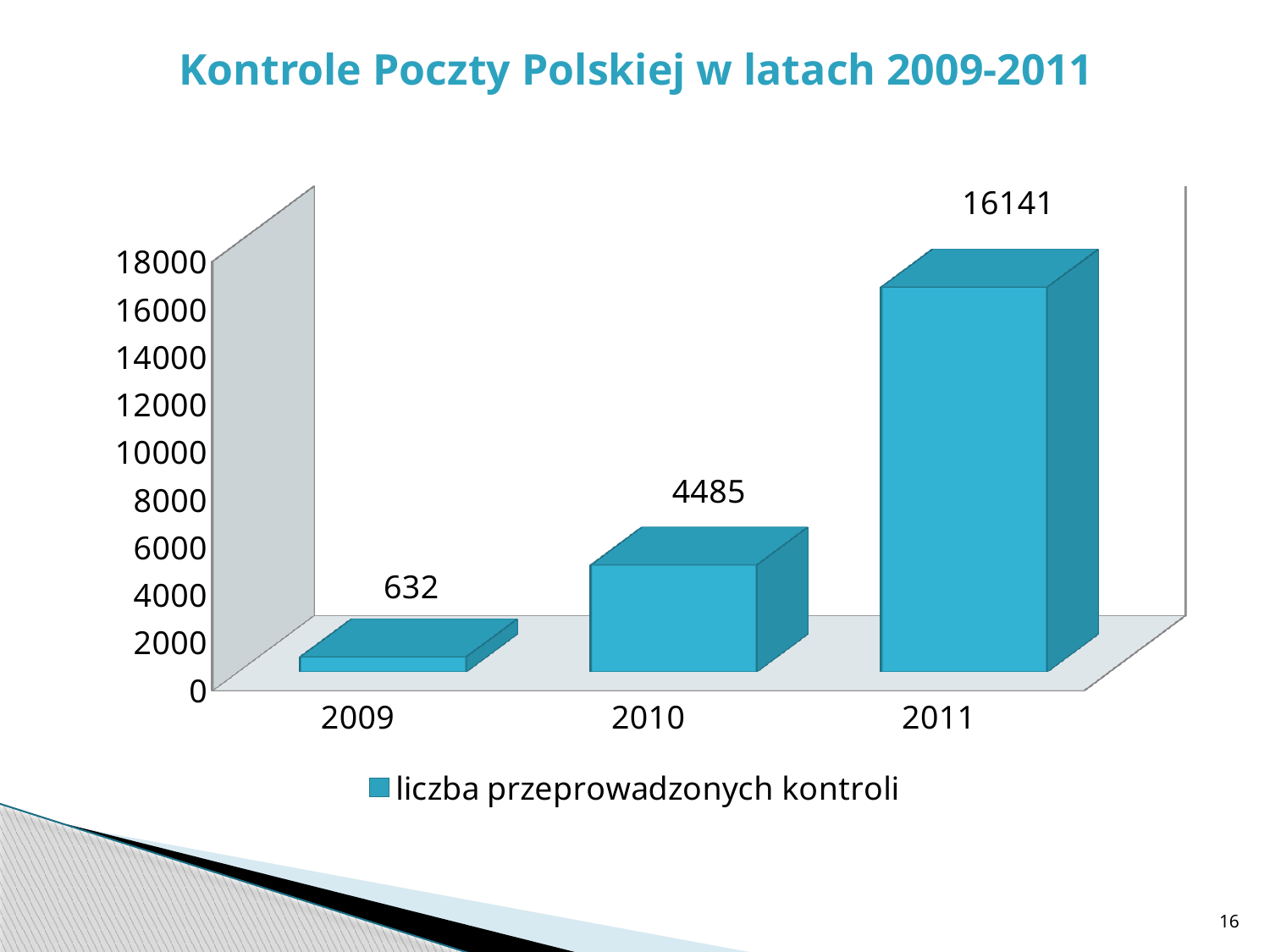
Is the value for 2011 greater or less than 14000? greater What kind of chart is shown on the slide? bar chart Which is larger, the value for 2010 or the value for 2009? 2010 What is the value for 2011? 16141 What is the difference between the values for 2010 and 2009? 3853 What is the value for 2010? 4485 What is the difference between the values for 2011 and 2010? 11656 What is the value for 2009? 632 Which year has the lowest value? 2009 How many years are shown on the x axis? 3 Do the values rise or fall from 2009 to 2011? rise Which year has the highest value? 2011